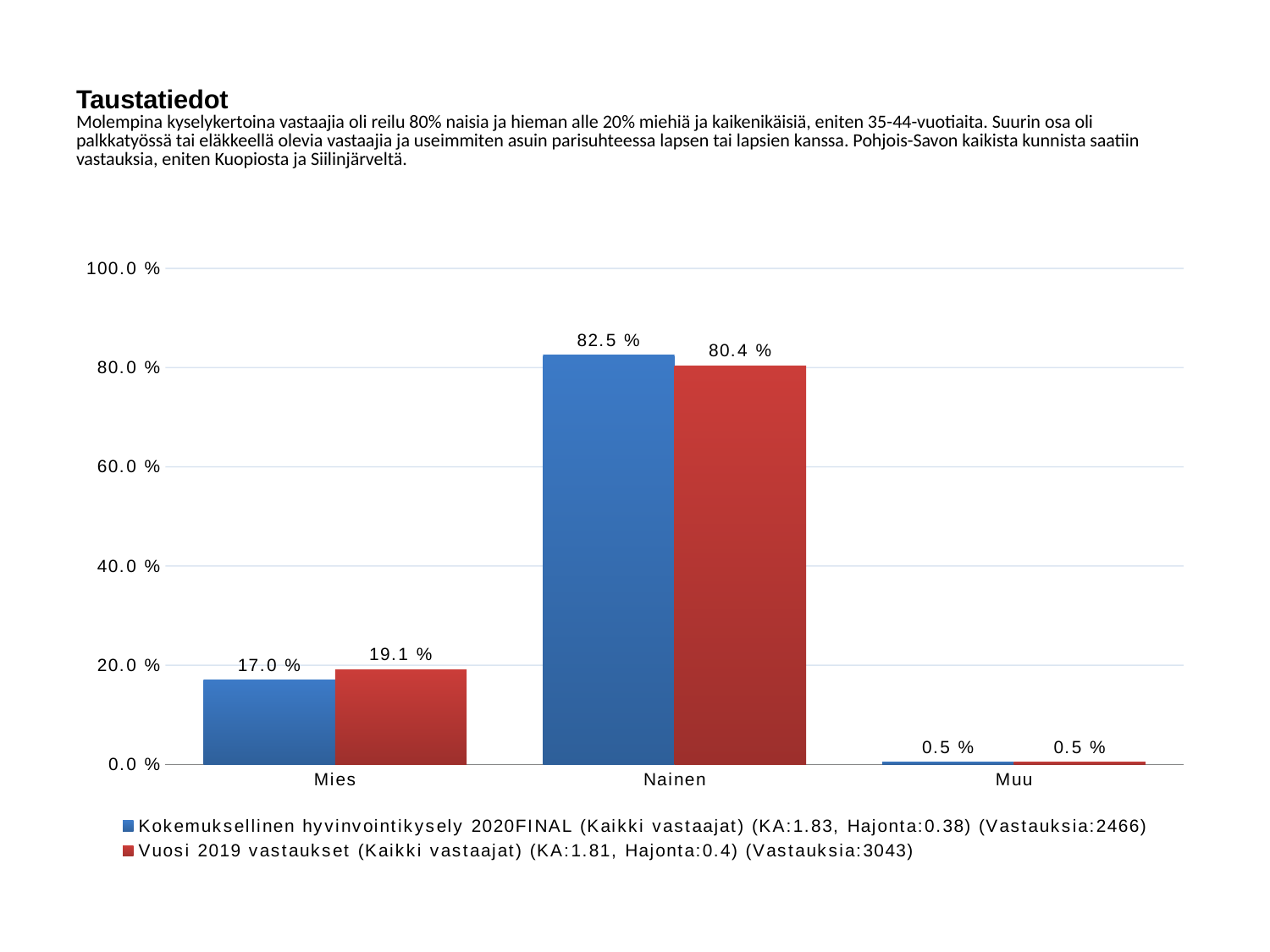
What kind of chart is shown on the slide? bar chart How many categories are shown on the x axis? 3 Is the value for Nainen in the Vuosi 2019 vastaukset series greater or less than 60.0 %? greater What is the value for Nainen in the Kokemuksellinen hyvinvointikysely 2020FINAL series? 82.5 % How many series does the legend list? 2 Which category has the lowest value in the Kokemuksellinen hyvinvointikysely 2020FINAL series? Muu What colour are the bars for the Vuosi 2019 vastaukset series? red What is the value for Muu in the Kokemuksellinen hyvinvointikysely 2020FINAL series? 0.5 % What is the value for Mies in the Vuosi 2019 vastaukset series? 19.1 % For Mies, which series has the larger value: Kokemuksellinen hyvinvointikysely 2020FINAL or Vuosi 2019 vastaukset? Vuosi 2019 vastaukset What is the difference between the Nainen values of the 2020FINAL series and the Vuosi 2019 series? 2.1 % Which category has the highest value in the Vuosi 2019 vastaukset series? Nainen